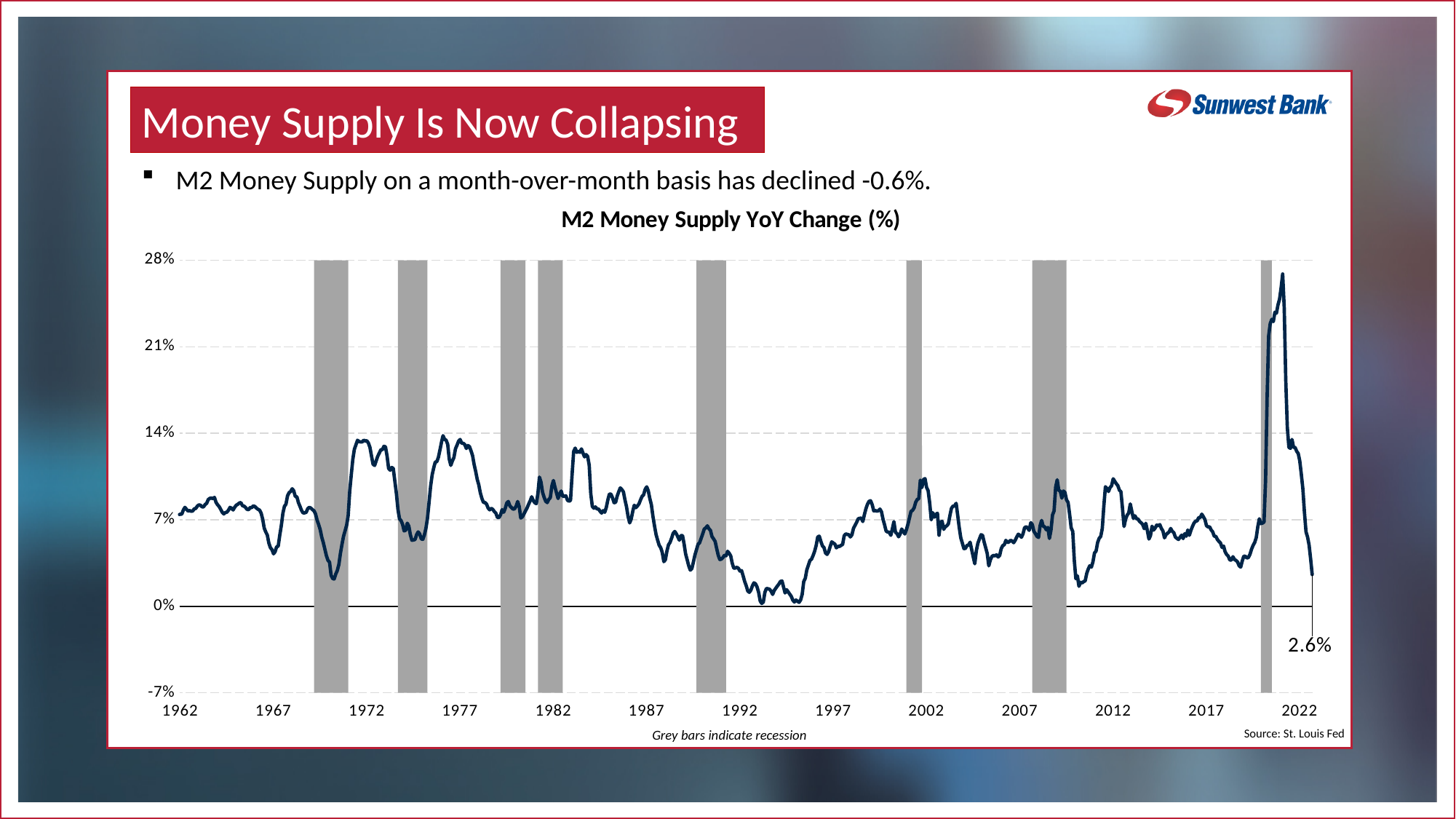
What is the title of the chart? M2 Money Supply YoY Change (%) Which is larger, the value of the line around 1977 or the value around 1995? 1977 What is the value shown by the data label at the end of the line in 2022? 2.6% What kind of chart is shown on the slide? line chart In which period does the line reach its highest point: the 1970s or the early 2020s? early 2020s Is the peak value of the line reached around 2021 greater or less than 21%? greater How many grey recession bars are shown on the chart? 8 Is the value of the line around 1972 greater or less than 7%? greater Is the value of the line around 1987 greater or less than 14%? less From its peak around 2021 to the end of the series in 2022, does the line rise or fall? fall According to the note below the chart, what do the grey bars indicate? recession